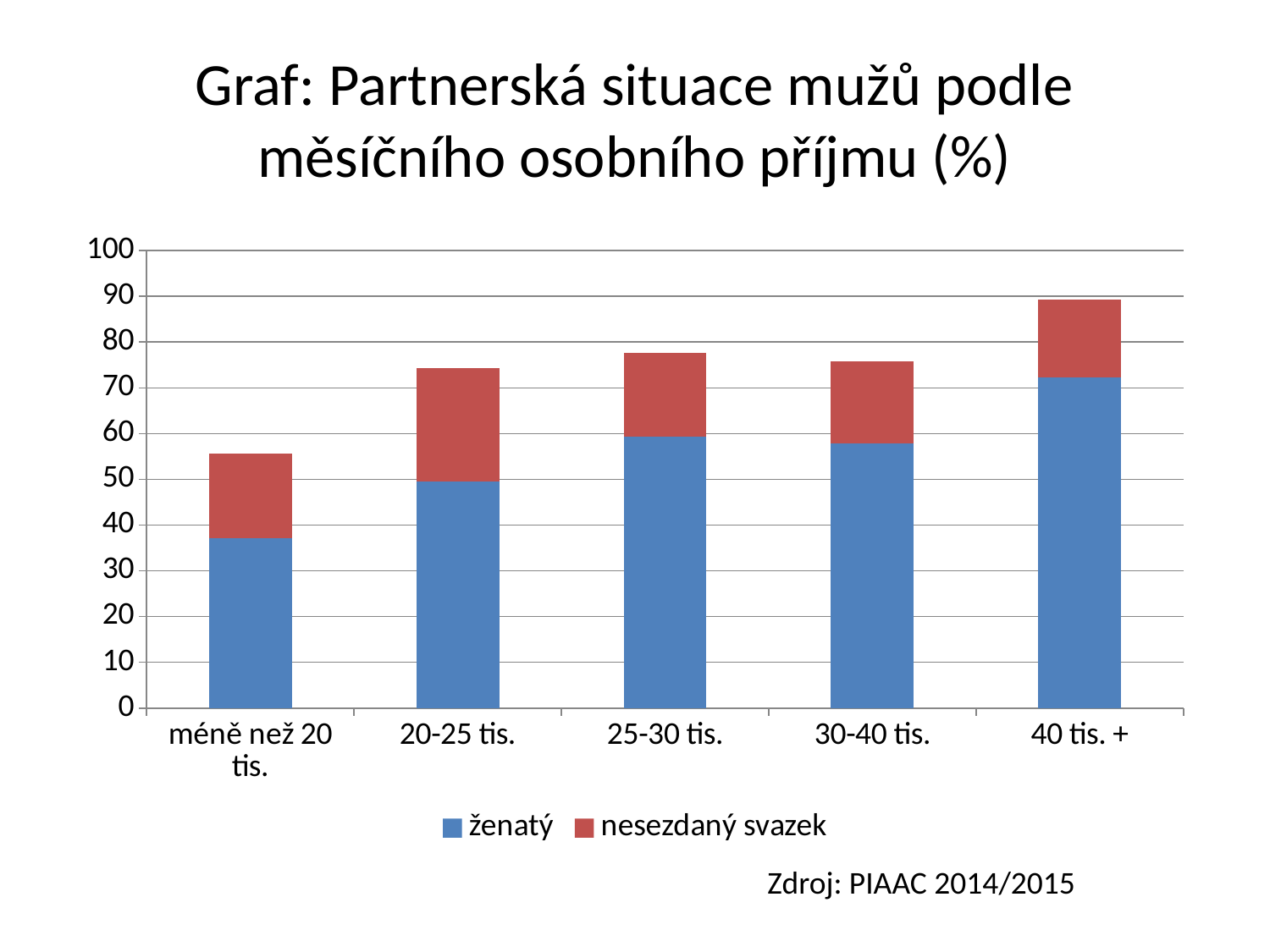
What kind of chart is shown on the slide? stacked bar chart Is the value for ženatý in the 40 tis. + category greater or less than 70? greater Which income category has the largest nesezdaný svazek segment? 20-25 tis. How many income categories are shown on the x axis? 5 Which income category has the lowest value for ženatý? méně než 20 tis. How many series does the legend list? 2 What source is cited below the chart? PIAAC 2014/2015 Which income category has the shortest stacked bar overall? méně než 20 tis. Which income category has the highest value for ženatý? 40 tis. + Which income category has the tallest stacked bar overall? 40 tis. + Is the value for ženatý in the méně než 20 tis. category greater or less than 40? less Which is larger, the ženatý value for 20-25 tis. or for 25-30 tis.? 25-30 tis.